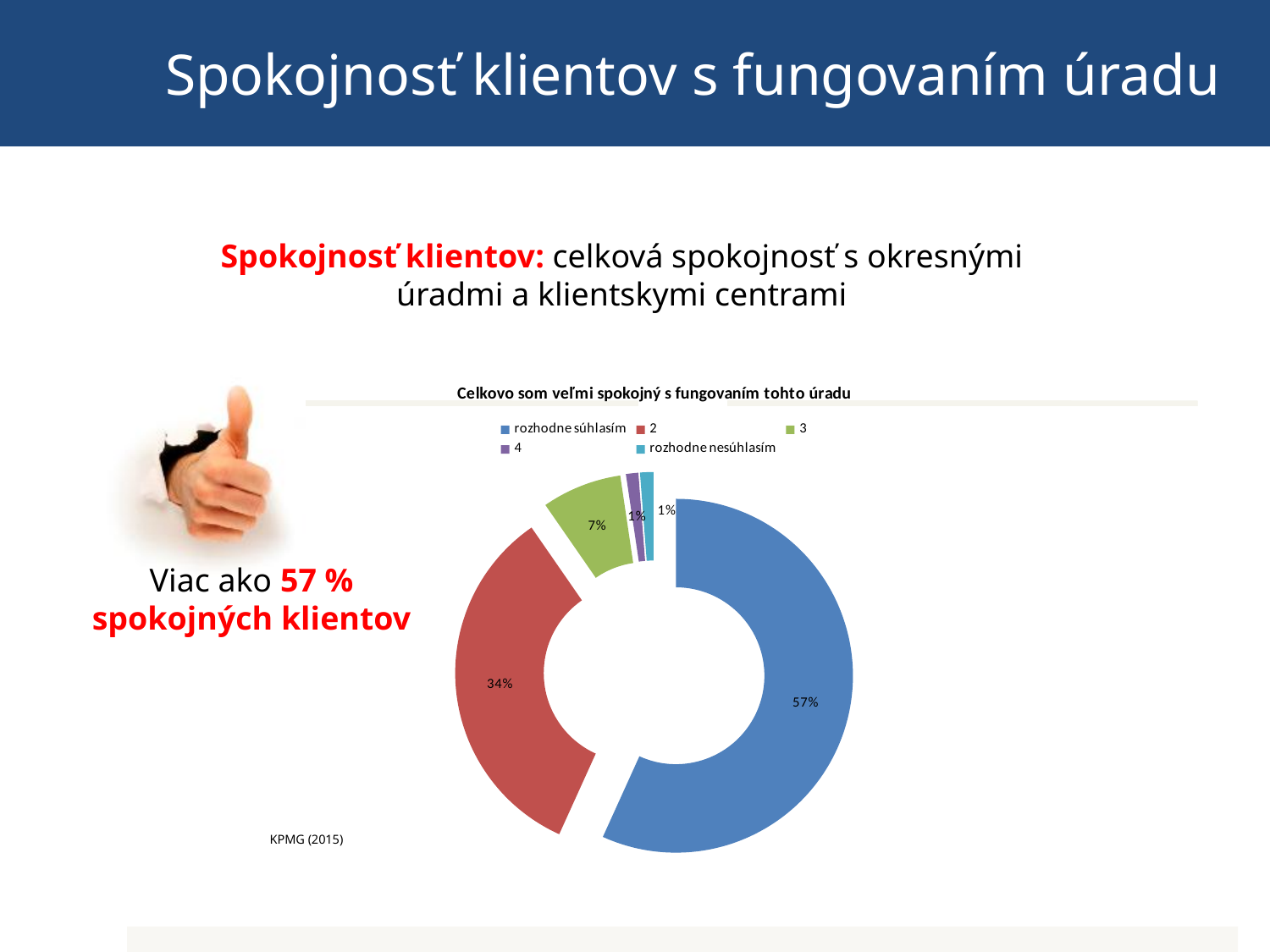
What kind of chart is shown on the slide? doughnut chart What is the combined share of "rozhodne súhlasím" and category "2"? 91% What percentage of respondents answered "rozhodne súhlasím"? 57% How many categories does the legend of the chart list? 5 What percentage is shown for "rozhodne nesúhlasím"? 1% What percentage is shown for category "2"? 34% What colour is the slice for "rozhodne súhlasím"? blue Which has a larger share, category "2" or category "3"? 2 What is the difference in percentage points between "rozhodne súhlasím" and category "2"? 23 What is the title of the chart? Celkovo som veľmi spokojný s fungovaním tohto úradu What percentage is shown for category "3"? 7% Which category has the largest share of the chart? rozhodne súhlasím